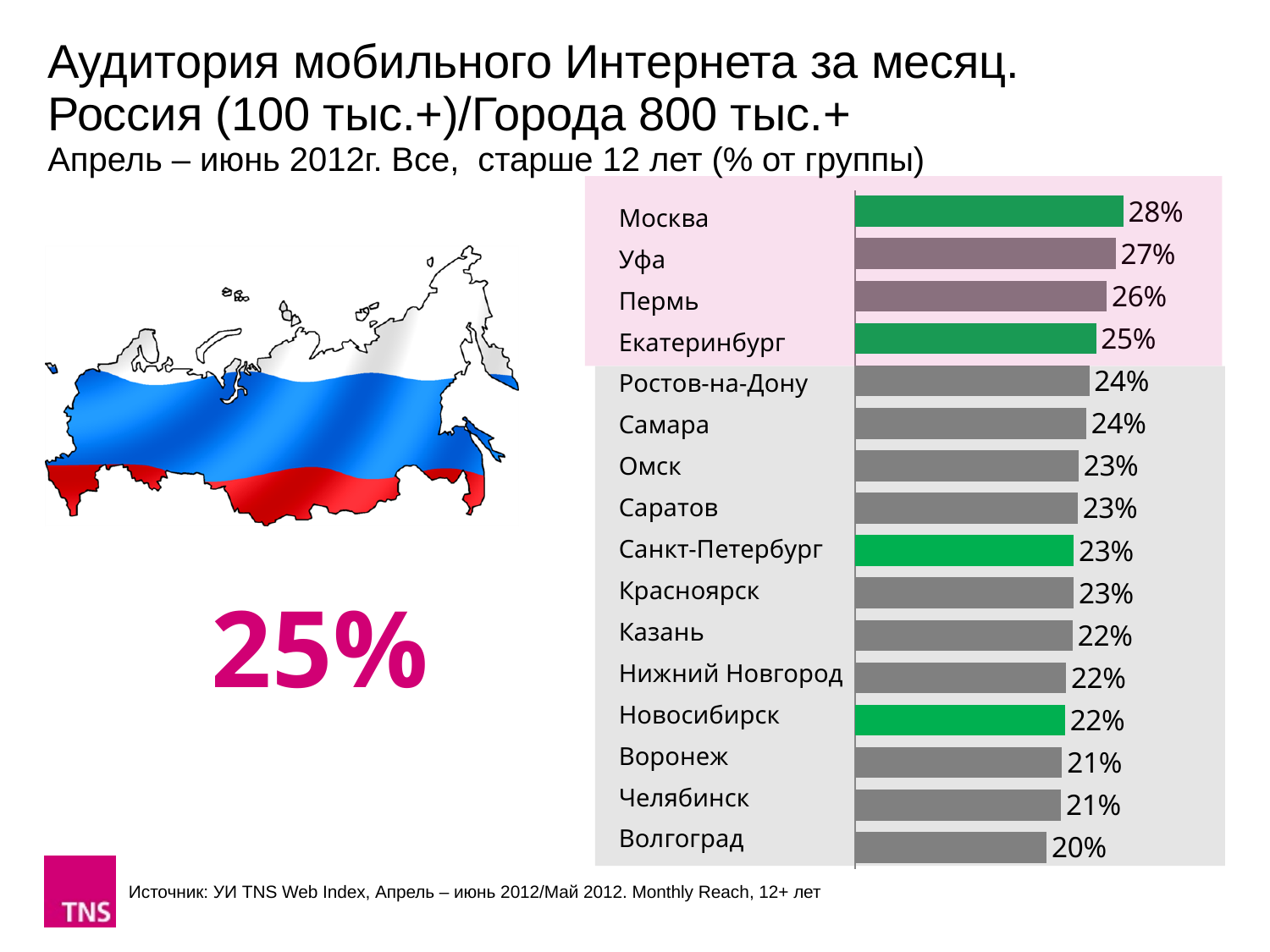
What is the value for Санкт-Петербург? 23% What is the value for Новосибирск? 22% Which city has the lowest value? Волгоград What kind of chart is shown on the slide? Bar chart What is the value for Волгоград? 20% What is the difference between the values for Москва and Волгоград? 8% What is the difference between the values for Уфа and Екатеринбург? 2% What large percentage is printed below the map of Russia? 25% How many cities are shown in the chart? 16 Which city has the highest value? Москва Which is larger, the value for Пермь or the value for Казань? Пермь What is the value for Москва? 28%